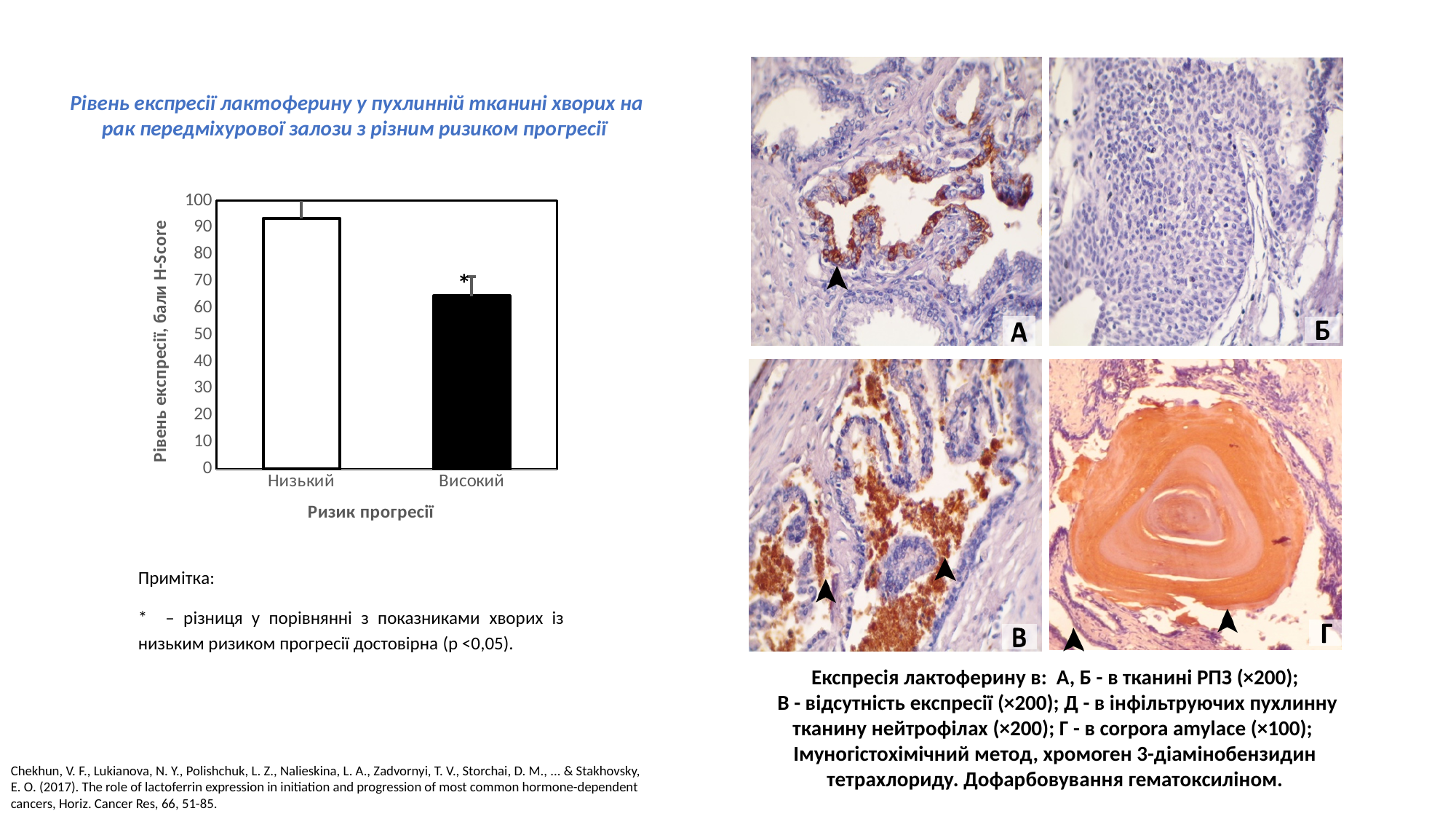
How many categories are shown on the x axis of the chart? 2 What is the label of the x axis of the chart? Ризик прогресії Is the value for Низький greater or less than 80? greater Which bar is taller, Низький or Високий? Низький Is the value for Високий greater or less than 70? less Is the value for Високий greater or less than 50? greater What kind of chart is shown on the slide? bar chart Which category has the highest bar in the chart? Низький What is the label of the y axis of the chart? Рівень експресії, бали H-Score Do the bar values rise or fall from Низький to Високий along the x axis? fall Which category has the lowest bar in the chart? Високий